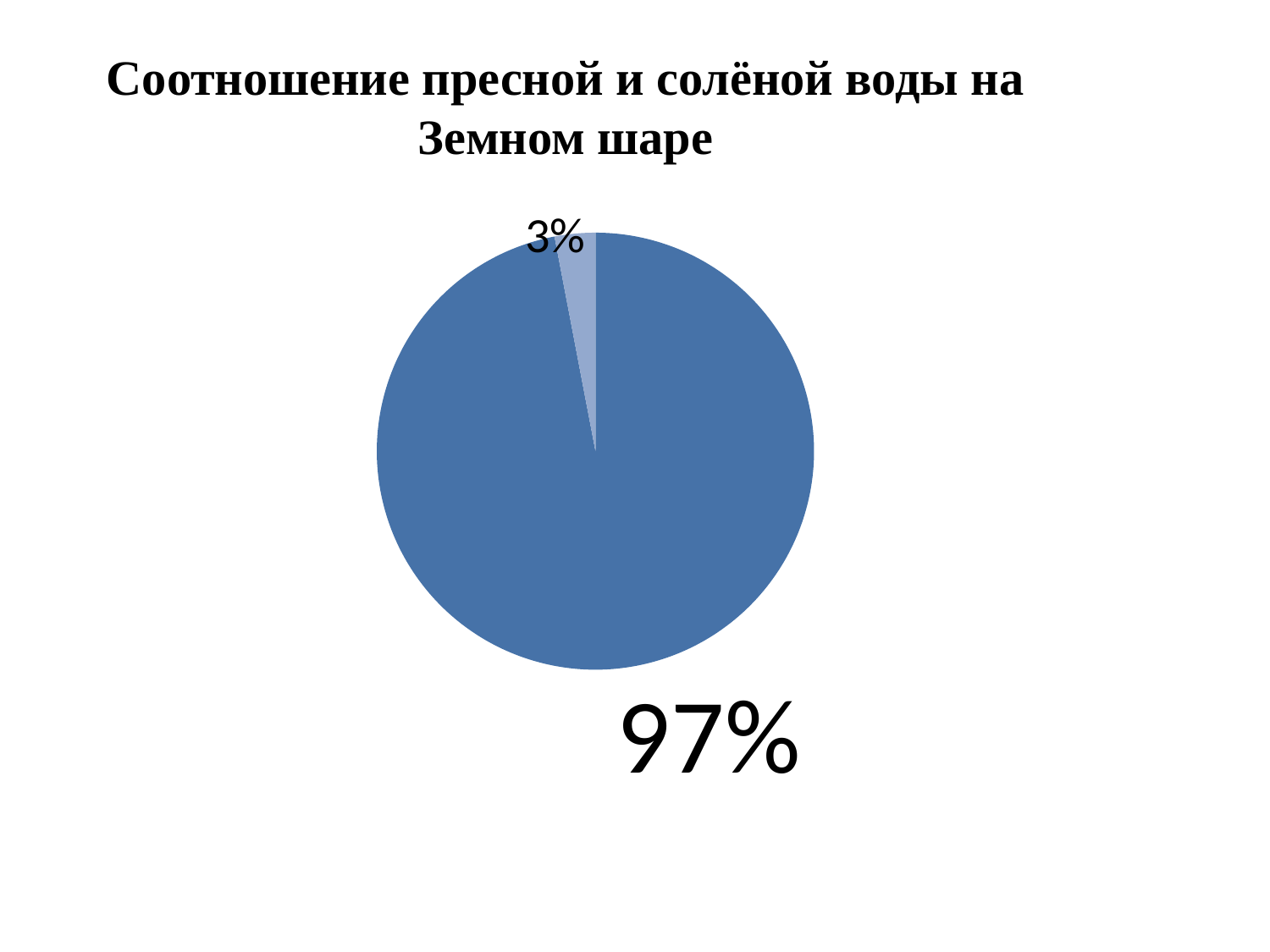
What value is labelled on the small light blue slice of the pie chart? 3% What is the title of the chart on the slide? Соотношение пресной и солёной воды на Земном шаре What kind of chart is shown on the slide? Pie chart What value is labelled on the large dark blue slice of the pie chart? 97% What is the value of the largest slice in the pie chart? 97% What is the difference between the two slice values shown on the pie chart? 94 percentage points How many slices does the pie chart have? 2 What is the value of the smallest slice in the pie chart? 3% Does the pie chart include a legend? No What do the two labelled slice values add up to? 100% What share of the pie does the light blue slice represent? 3% Which slice is larger, the dark blue one or the light blue one? The dark blue one